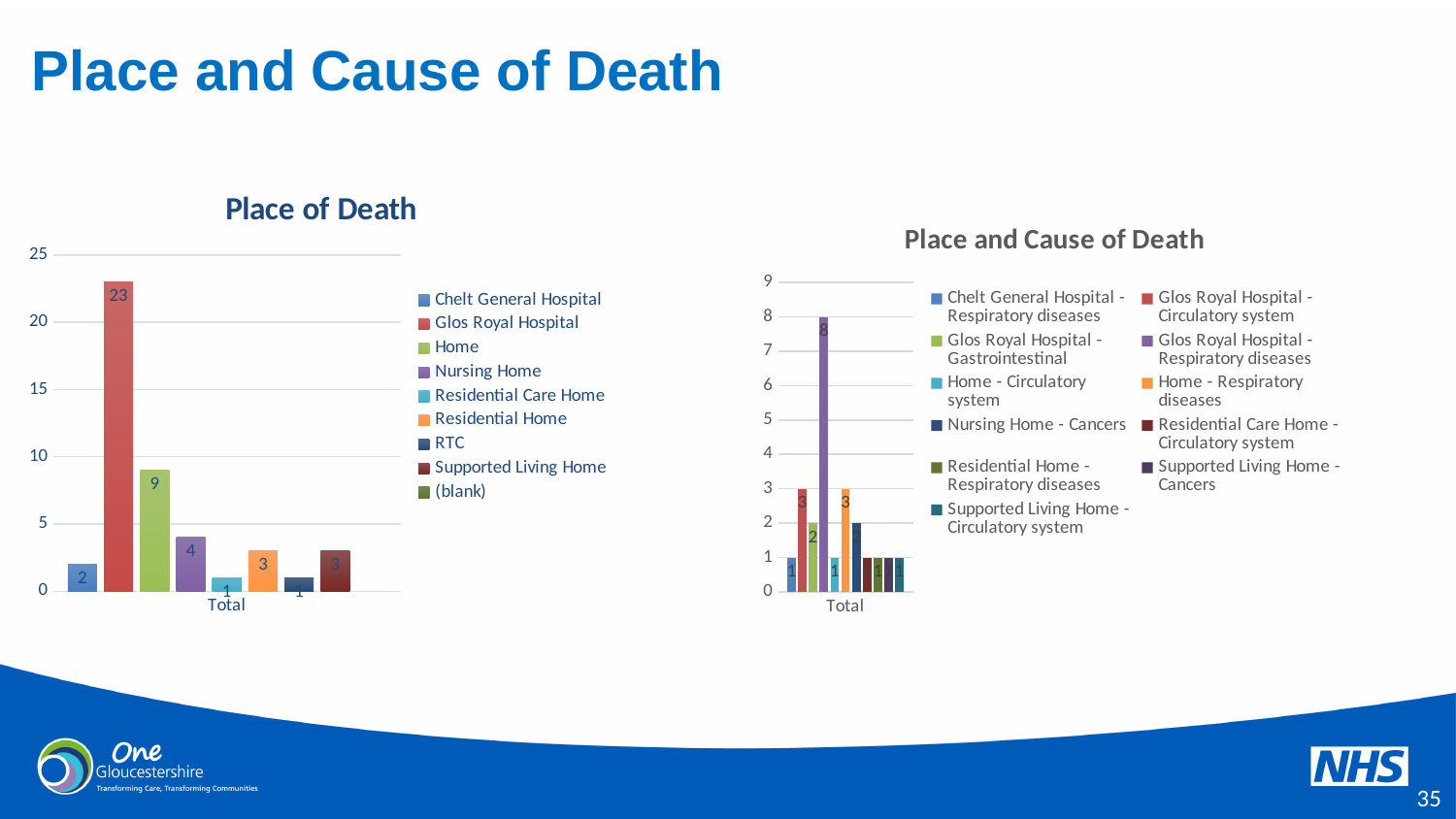
How many entries does the legend of the 'Place of Death' chart list? 9 In the 'Place and Cause of Death' chart, which is larger: Glos Royal Hospital - Circulatory system or Glos Royal Hospital - Gastrointestinal? Glos Royal Hospital - Circulatory system In the 'Place and Cause of Death' chart, which series has the highest value? Glos Royal Hospital - Respiratory diseases In the 'Place and Cause of Death' chart, what is the value for Home - Respiratory diseases? 3 How many entries does the legend of the 'Place and Cause of Death' chart list? 11 In the 'Place of Death' chart, what is the value for Home? 9 In the 'Place of Death' chart, which place has the highest value? Glos Royal Hospital In the 'Place of Death' chart, what is the difference between the values for Glos Royal Hospital and Home? 14 In the 'Place of Death' chart, what is the value for Glos Royal Hospital? 23 What kind of chart is the 'Place of Death' chart? Bar chart In the 'Place and Cause of Death' chart, what is the value for Glos Royal Hospital - Respiratory diseases? 8 In the 'Place of Death' chart, what is the value for Nursing Home? 4